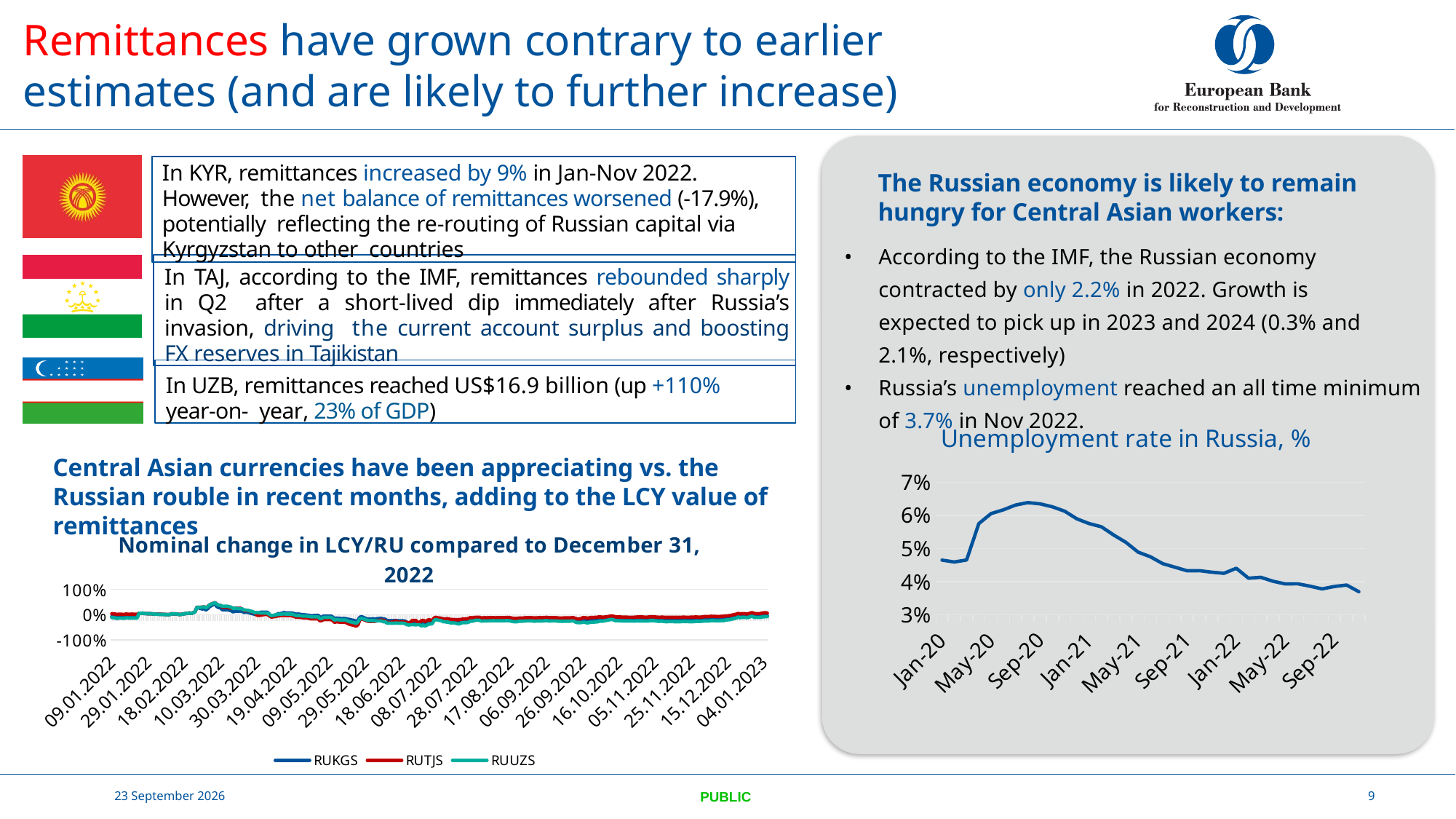
In the 'Unemployment rate in Russia, %' chart, does the unemployment rate rise or fall between Sep-20 and Sep-22? fall What kind of chart is the 'Unemployment rate in Russia, %' chart? line chart In the 'Unemployment rate in Russia, %' chart, which is higher: the value at Sep-20 or the value at Sep-22? Sep-20 How many x-axis labels are shown on the 'Unemployment rate in Russia, %' chart? 9 What kind of chart is the 'Nominal change in LCY/RU compared to December 31, 2022' chart? line chart What is the last date label on the x axis of the 'Nominal change in LCY/RU compared to December 31, 2022' chart? 04.01.2023 How many series does the legend of the 'Nominal change in LCY/RU compared to December 31, 2022' chart list? 3 In the 'Unemployment rate in Russia, %' chart, is the value around Sep-20 greater or less than 6%? greater In the 'Unemployment rate in Russia, %' chart, is the value at Sep-22 greater or less than 4%? less What is the highest y-axis tick shown on the 'Unemployment rate in Russia, %' chart? 7% In the 'Unemployment rate in Russia, %' chart, is the value at Jan-20 greater or less than 5%? less What are the legend entries of the 'Nominal change in LCY/RU compared to December 31, 2022' chart? RUKGS, RUTJS, RUUZS